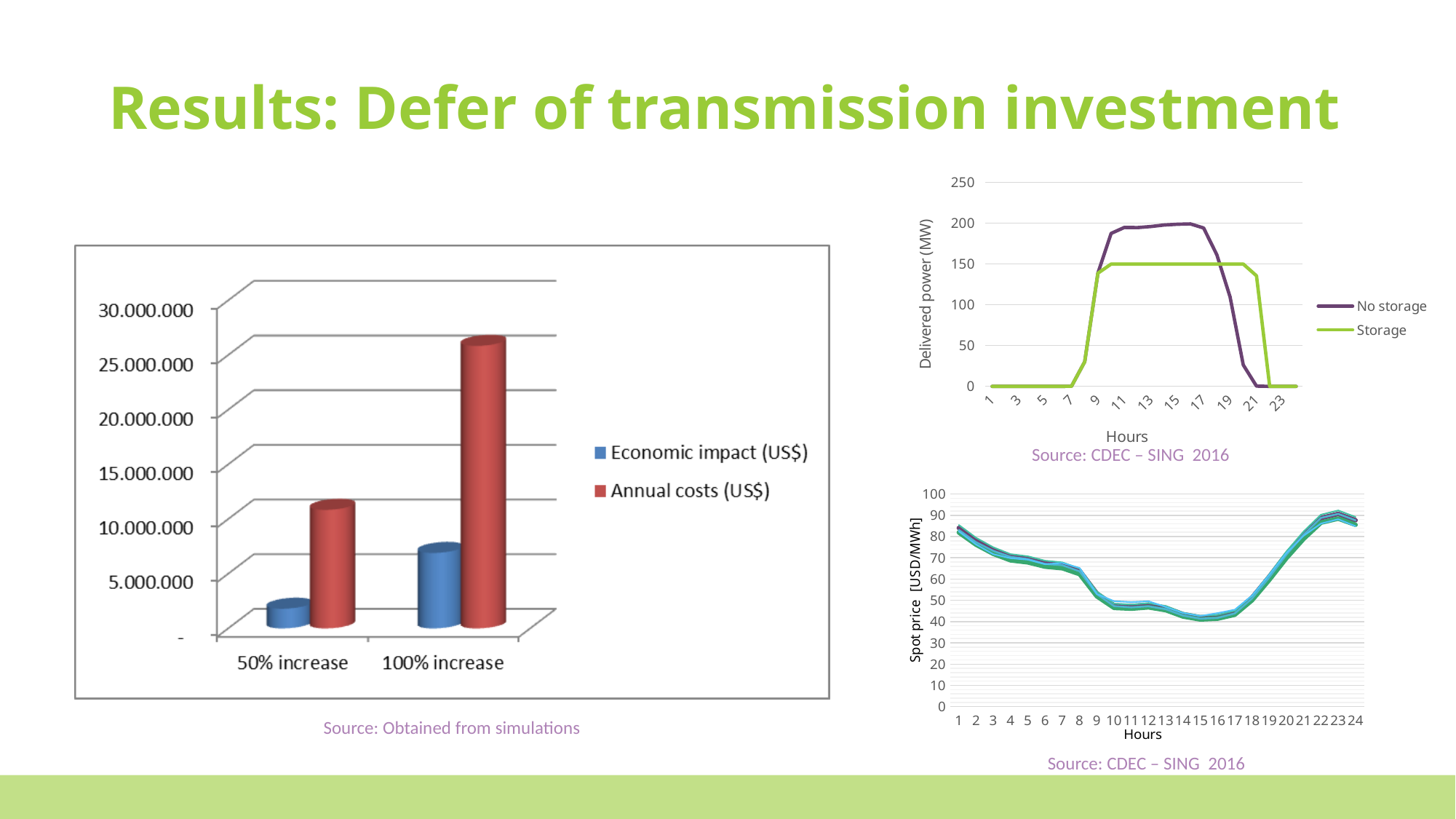
In the top-right chart of Delivered power (MW), which series reaches the higher peak, 'No storage' or 'Storage'? No storage How many categories are shown on the x axis of the left bar chart? 2 In the left bar chart, is the value of Economic impact (US$) for '50% increase' greater or less than 5.000.000? less In the top-right chart of Delivered power (MW), is the 'No storage' value at hour 15 greater or less than 150? greater In the top-right chart of Delivered power (MW), how many series does the legend list? 2 In the left bar chart, which category has the higher Annual costs (US$)? 100% increase In the left bar chart, which series is shown in red? Annual costs (US$) In the left bar chart, which is larger for '100% increase': Economic impact (US$) or Annual costs (US$)? Annual costs (US$) In the bottom-right chart of Spot price [USD/MWh], do the values rise or fall from hour 1 to hour 15? fall How many series does the legend of the left bar chart list? 2 What kind of chart is the left chart with the categories '50% increase' and '100% increase'? bar chart In the left bar chart, is the value of Annual costs (US$) for '100% increase' greater or less than 20.000.000? greater